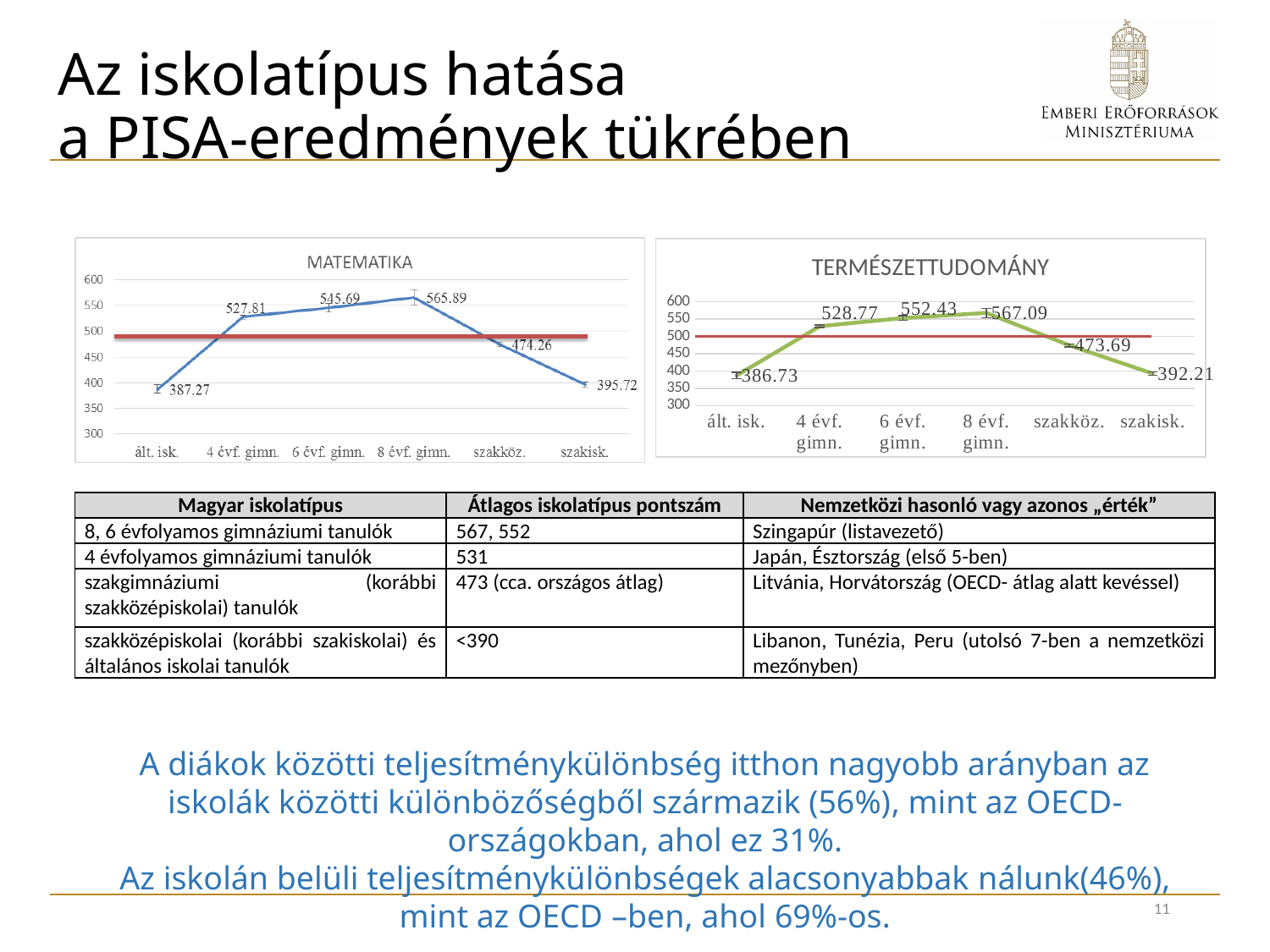
In the TERMÉSZETTUDOMÁNY chart, what is the value for szakköz.? 473.69 In the TERMÉSZETTUDOMÁNY chart, what is the value for 4 évf. gimn.? 528.77 What kind of chart is the TERMÉSZETTUDOMÁNY chart? line chart How many categories are shown on the x axis of the MATEMATIKA chart? 6 In the MATEMATIKA chart, what is the value for ált. isk.? 387.27 In the TERMÉSZETTUDOMÁNY chart, which category has the highest value? 8 évf. gimn. In the TERMÉSZETTUDOMÁNY chart, is the value for szakisk. greater or less than 400? less In the MATEMATIKA chart, what is the value for 8 évf. gimn.? 565.89 In the TERMÉSZETTUDOMÁNY chart, what is the difference between the values for 6 évf. gimn. and ált. isk.? 165.70 In the MATEMATIKA chart, which is larger, the value for szakköz. or the value for szakisk.? szakköz. In the MATEMATIKA chart, which category has the lowest value? ált. isk. In the MATEMATIKA chart, what is the difference between the values for 8 évf. gimn. and szakisk.? 170.17